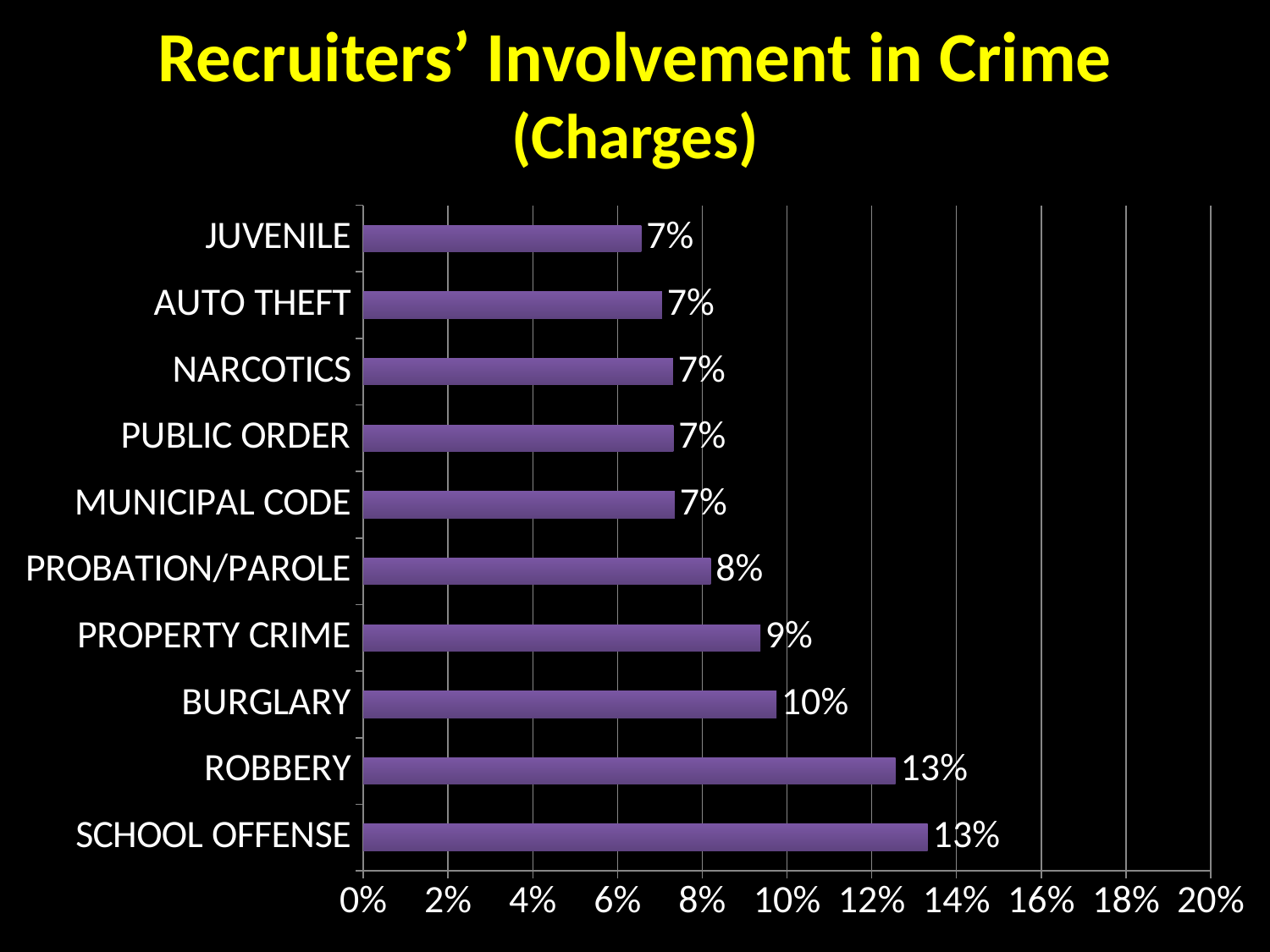
What is the value for JUVENILE? 7% How many categories are shown on the chart? 10 What is the value for ROBBERY? 13% What is the difference between the values for ROBBERY and BURGLARY? 3% Is the value for SCHOOL OFFENSE greater or less than 12%? greater What is the value for PROBATION/PAROLE? 8% What is the difference between the values for BURGLARY and PROBATION/PAROLE? 2% What kind of chart is shown on the slide? bar chart Which is larger, the value for PROPERTY CRIME or the value for NARCOTICS? PROPERTY CRIME Which is larger, the value for ROBBERY or the value for BURGLARY? ROBBERY What is the value for BURGLARY? 10% What is the value for PROPERTY CRIME? 9%